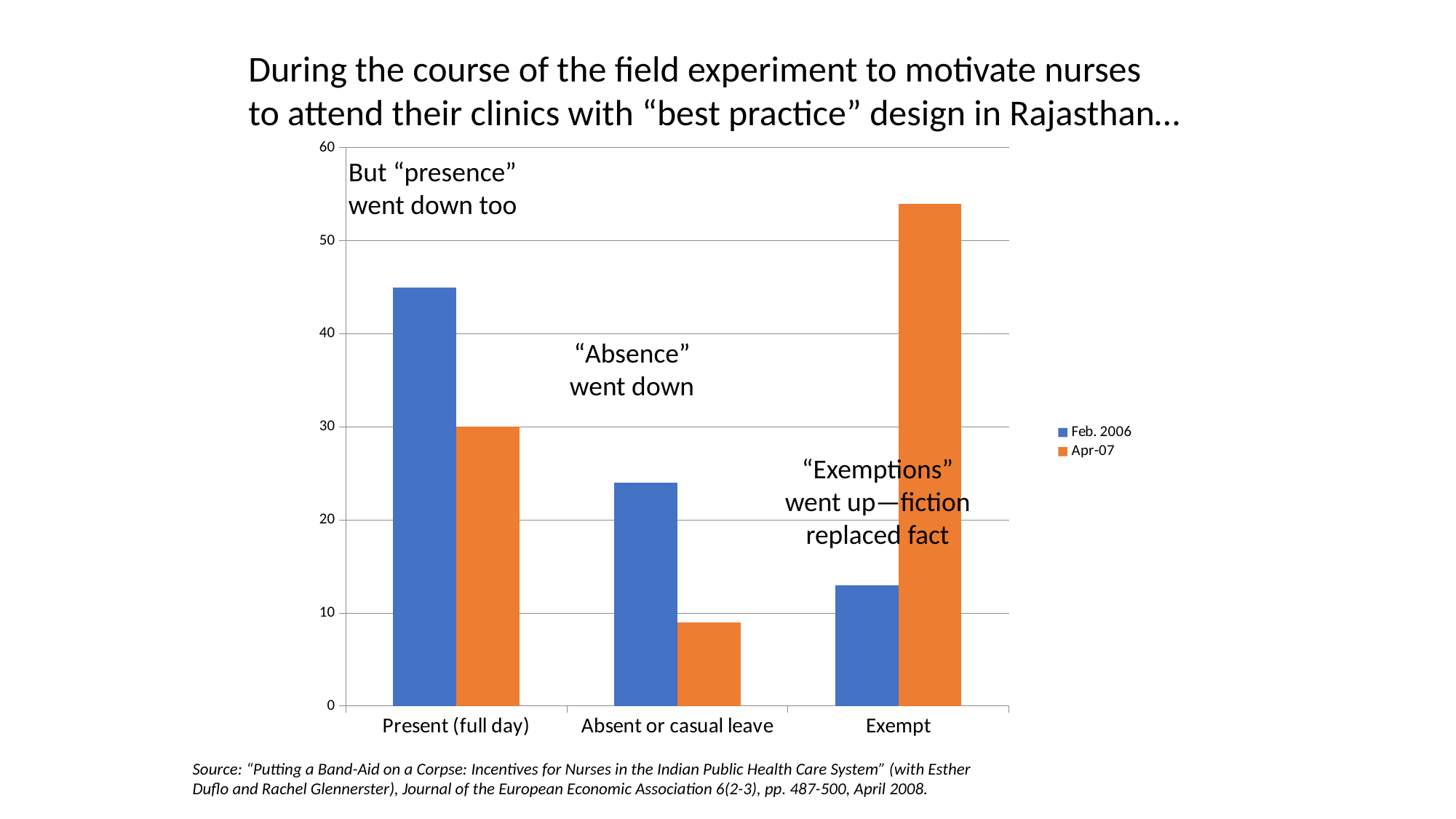
Is the Feb. 2006 value for Present (full day) greater or less than 40? greater Is the Apr-07 value for Absent or casual leave greater or less than 10? less What is the Apr-07 value for Present (full day)? 30 Which category has the tallest Apr-07 bar? Exempt What are the two series named in the legend? Feb. 2006 and Apr-07 Is the Feb. 2006 value for Absent or casual leave greater or less than 20? greater What kind of chart is shown on the slide? bar chart For Present (full day), which series has the larger value, Feb. 2006 or Apr-07? Feb. 2006 Which category has the lowest Feb. 2006 value? Exempt How many categories are shown on the x axis of the chart? 3 How many series does the chart's legend list? 2